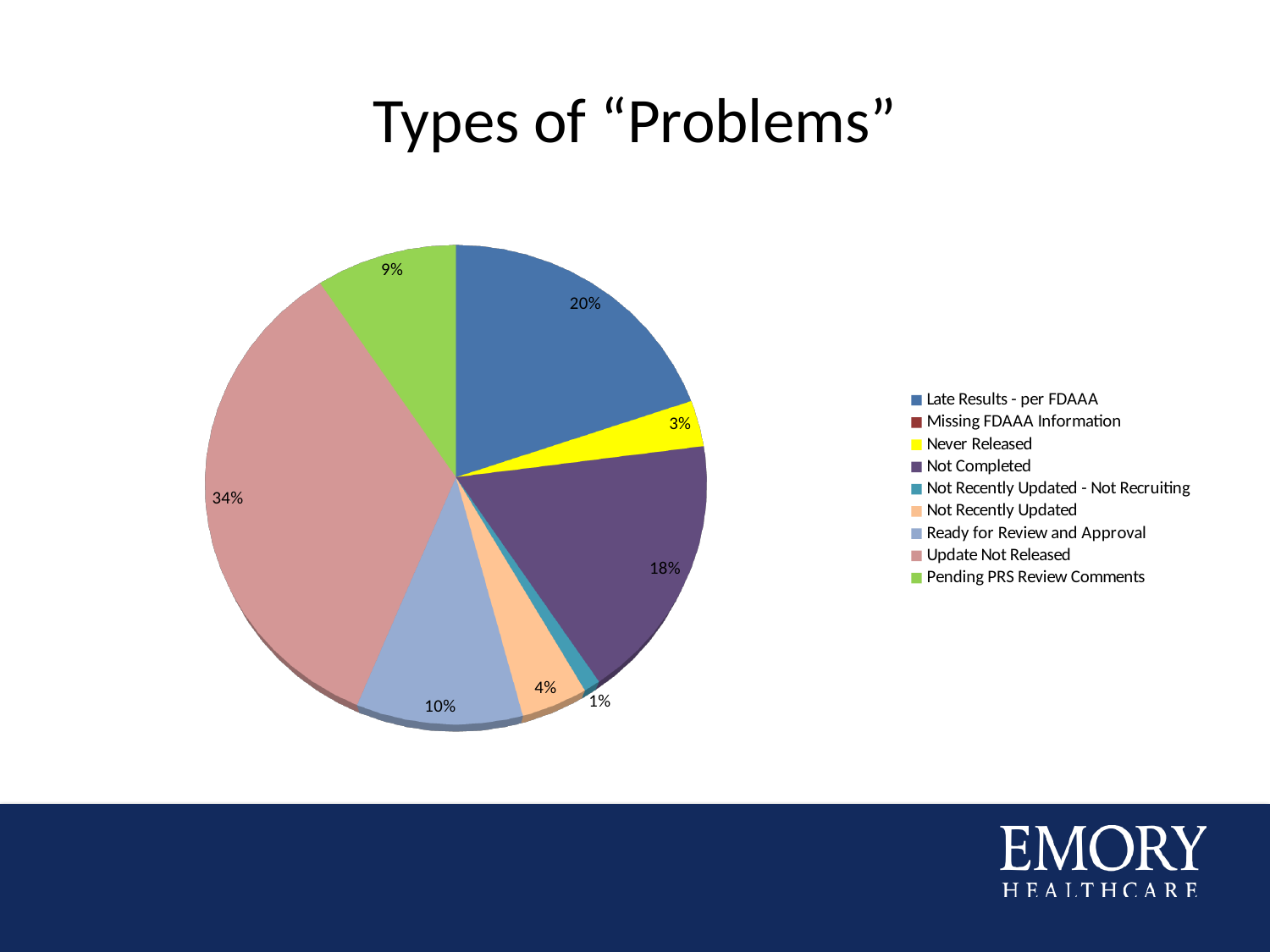
What share of the pie is Not Completed? 18% What share of the pie is Update Not Released? 34% Which category has the largest slice of the pie? Update Not Released What is the difference between the Update Not Released share and the Late Results - per FDAAA share? 14% Which is larger, the Never Released slice or the Not Recently Updated slice? Not Recently Updated What kind of chart is shown on the slide? pie chart Which labeled slice is the smallest? Not Recently Updated - Not Recruiting What share of the pie is Pending PRS Review Comments? 9% What is the title of the chart? Types of "Problems" How many entries does the legend list? 9